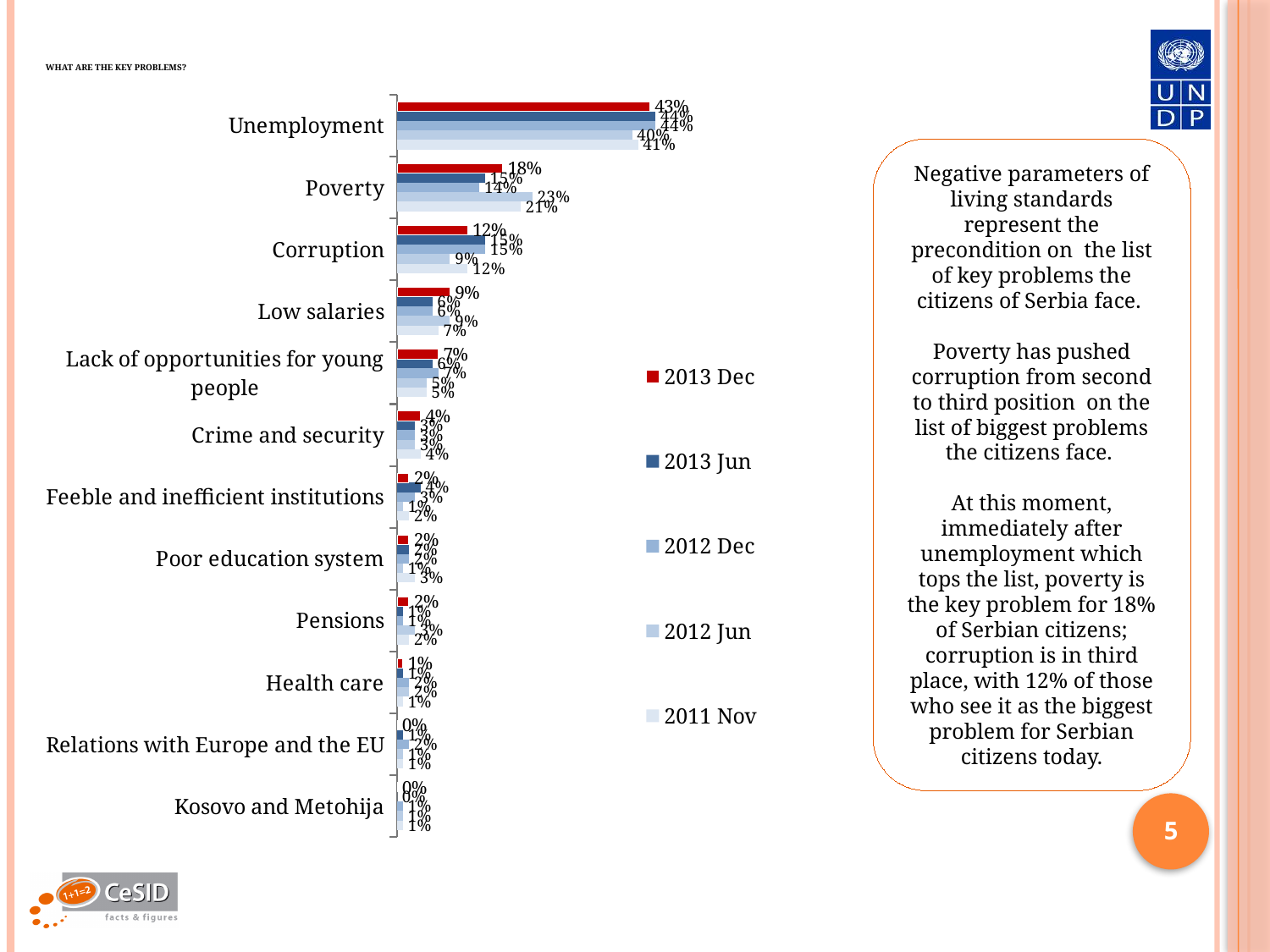
What is the value for Corruption in the 2013 Dec series? 12% In the 2013 Dec series, which is larger: Poverty or Corruption? Poverty Which category has the highest value in the 2013 Dec series? Unemployment What is the value for Poverty in the 2013 Dec series? 18% Which series is listed first in the legend? 2013 Dec What is the difference between Unemployment and Poverty in the 2013 Dec series? 25 percentage points How many categories (problems) are listed on the chart? 12 What is the value for Poverty in the 2012 Jun series? 23% How many series does the legend list? 5 What is the value for Low salaries in the 2013 Dec series? 9% What kind of chart is shown on the slide? Bar chart What is the value for Unemployment in the 2013 Dec series? 43%